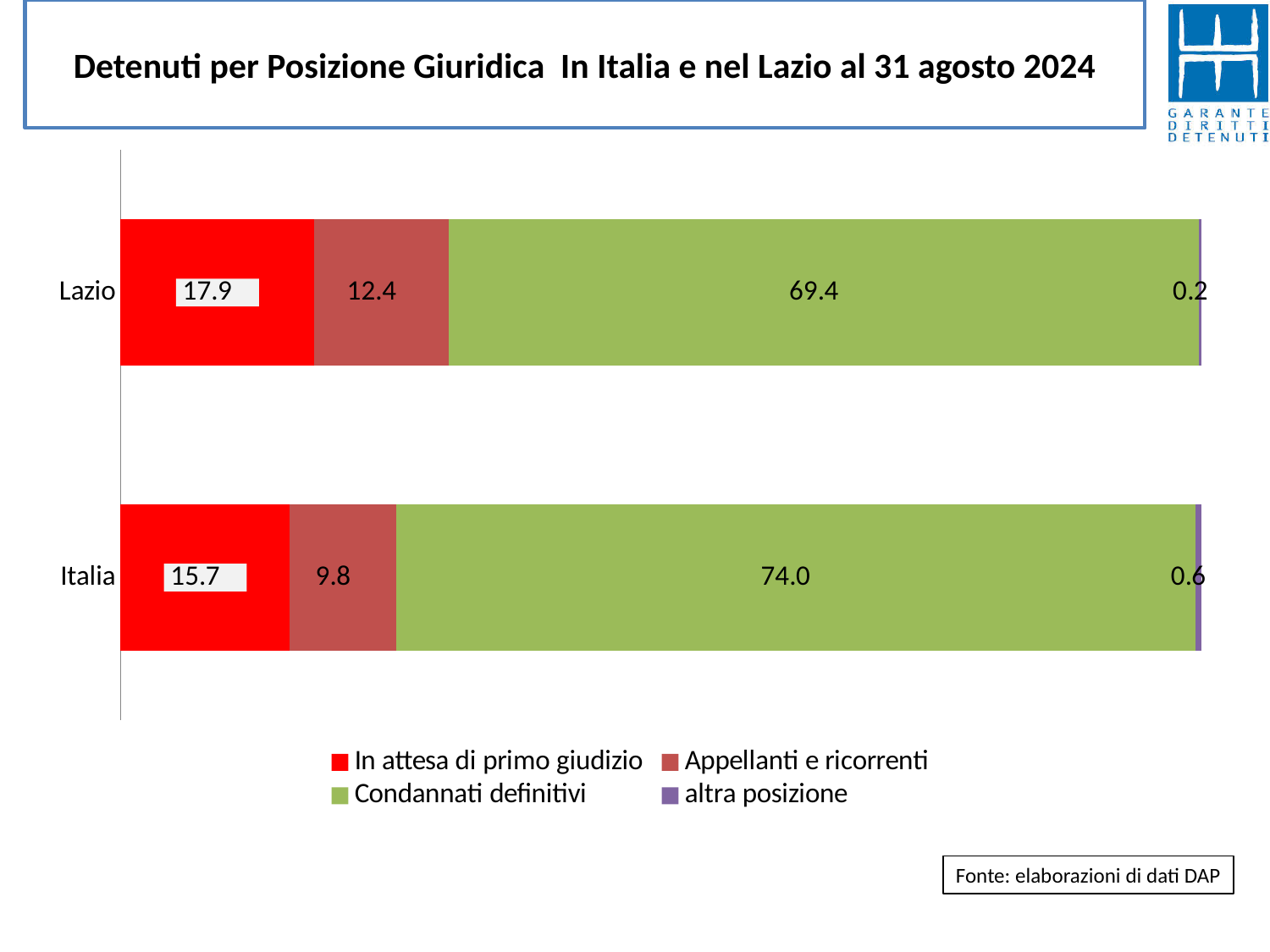
Which series has the largest value in the Lazio bar? Condannati definitivi What is the difference between the 'In attesa di primo giudizio' values for Lazio and Italia? 2.2 How many categories are shown on the chart? 2 Which series has the smallest value in the Italia bar? altra posizione Which has the larger 'Appellanti e ricorrenti' value, Lazio or Italia? Lazio How many series does the legend list? 4 What kind of chart is shown on the slide? Stacked bar chart What is the value for 'Appellanti e ricorrenti' for Lazio? 12.4 What is the value for 'Condannati definitivi' for Italia? 74.0 What is the value for 'altra posizione' for Italia? 0.6 What is the difference between the 'Condannati definitivi' values for Italia and Lazio? 4.6 What is the value for 'In attesa di primo giudizio' for Lazio? 17.9